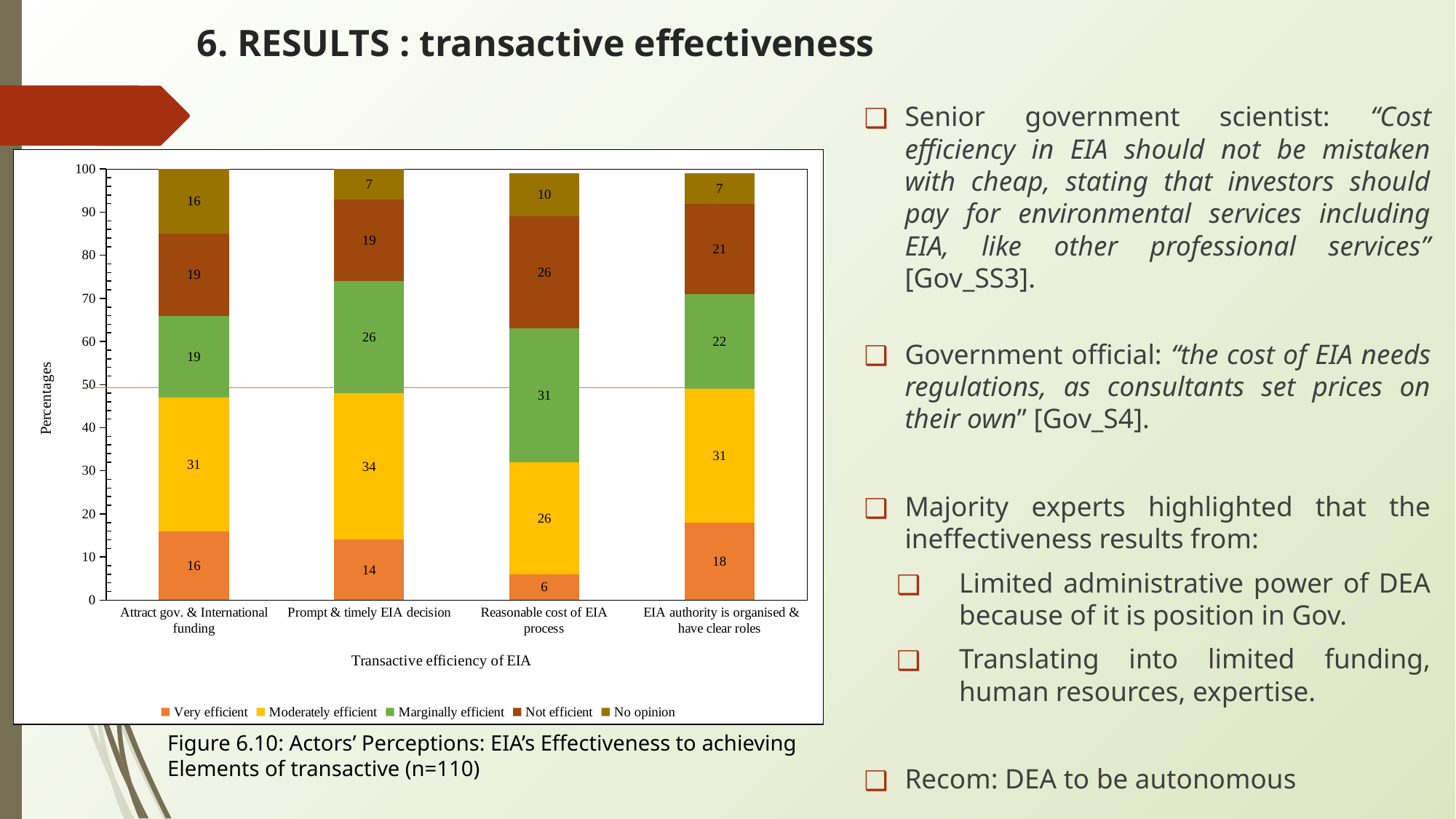
What is the title of the y axis? Percentages What is the 'Moderately efficient' value for 'Prompt & timely EIA decision'? 34 What is the 'No opinion' value for 'Attract gov. & International funding'? 16 What is the 'Very efficient' value for 'Reasonable cost of EIA process'? 6 What is the difference between the 'Not efficient' values for 'Reasonable cost of EIA process' and 'Attract gov. & International funding'? 7 What kind of chart is shown on the slide? Stacked bar chart Which category has the lowest 'Very efficient' value? Reasonable cost of EIA process Which category has the highest 'No opinion' value? Attract gov. & International funding How many series does the legend list? 5 Which has the larger 'Marginally efficient' value: 'Prompt & timely EIA decision' or 'Reasonable cost of EIA process'? Reasonable cost of EIA process How many categories are shown on the x axis? 4 Which category has the highest 'Very efficient' value? EIA authority is organised & have clear roles